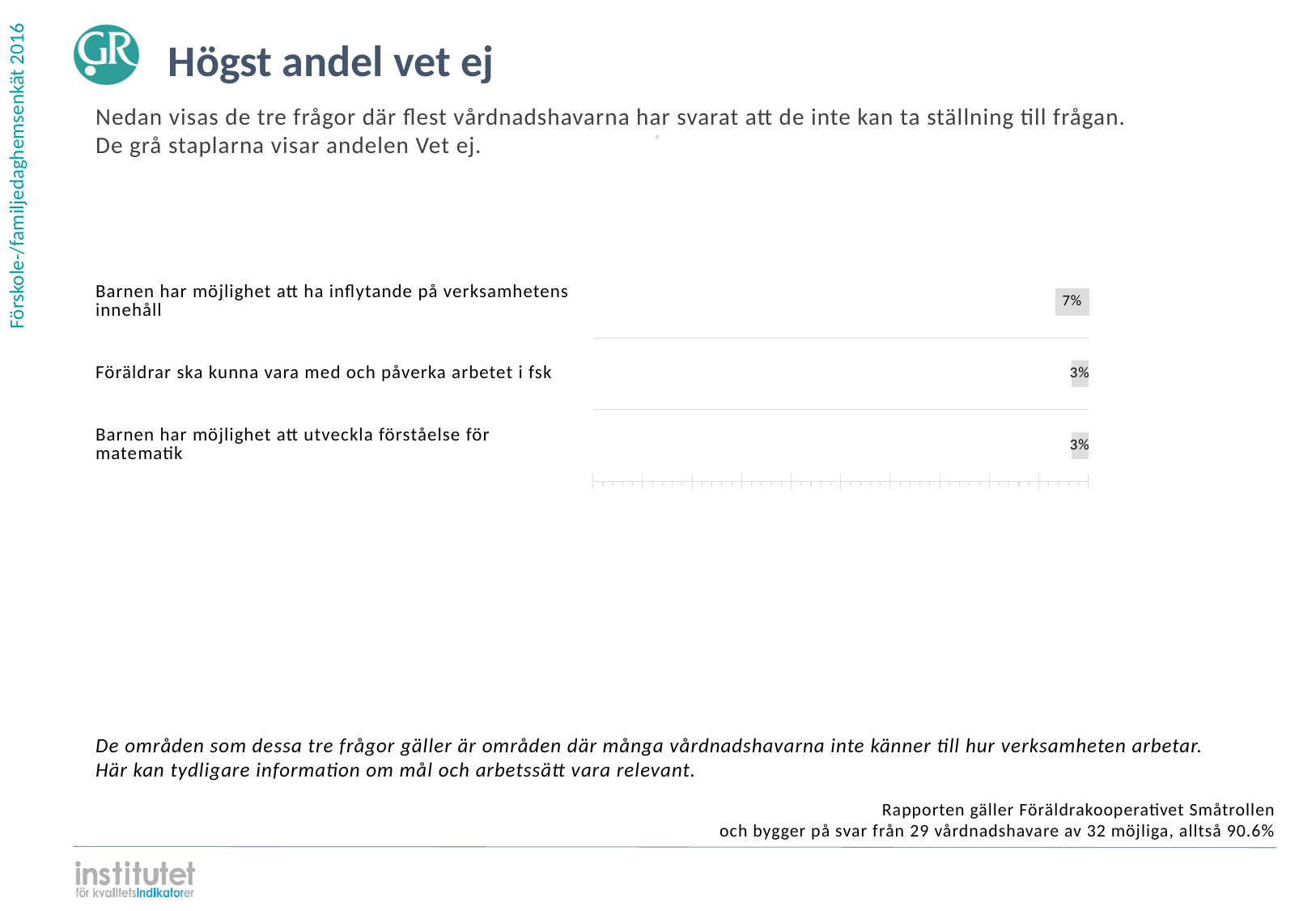
What is the Vet ej share for "Föräldrar ska kunna vara med och påverka arbetet i fsk"? 3% What colour are the bars in the chart? Grey What kind of chart is shown on the slide? Bar chart How many categories share the same Vet ej value of 3%? 2 Which has a larger Vet ej share: "Barnen har möjlighet att ha inflytande på verksamhetens innehåll" or "Barnen har möjlighet att utveckla förståelse för matematik"? Barnen har möjlighet att ha inflytande på verksamhetens innehåll What is the difference in percentage points between the Vet ej share for "Barnen har möjlighet att ha inflytande på verksamhetens innehåll" and for "Föräldrar ska kunna vara med och påverka arbetet i fsk"? 4 percentage points What is the title of the slide containing the chart? Högst andel vet ej Which question has the highest Vet ej share? Barnen har möjlighet att ha inflytande på verksamhetens innehåll What is the Vet ej share for "Barnen har möjlighet att utveckla förståelse för matematik"? 3% How many questions (categories) are shown in the chart? 3 What is the Vet ej share for "Barnen har möjlighet att ha inflytande på verksamhetens innehåll"? 7%